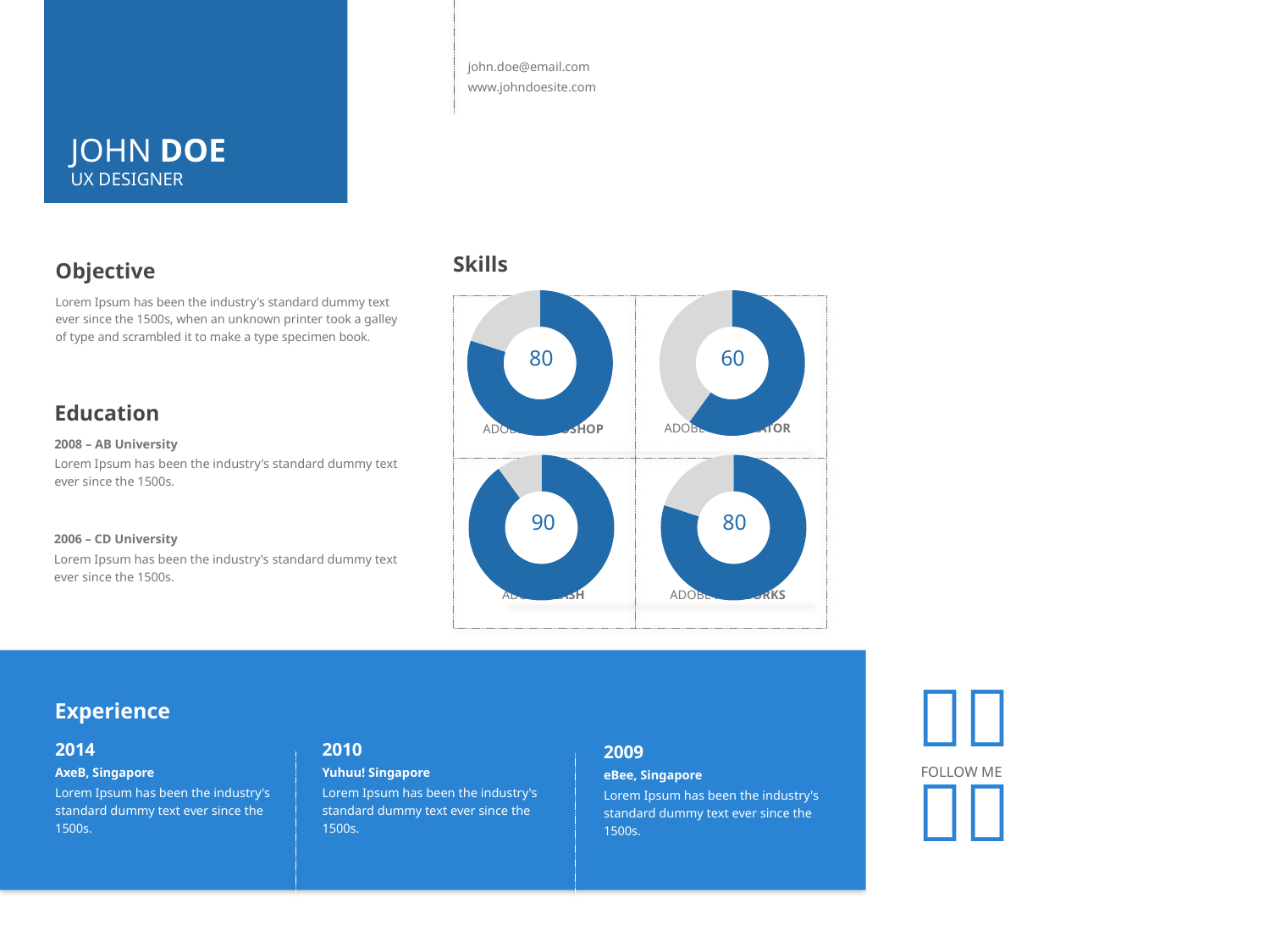
What colour is the filled portion of the donut charts in the Skills section? Blue What is the difference between the value in the top-left Skills donut chart and the value in the bottom-left Skills donut chart? 10 How many donut charts are shown in the Skills section? 4 Which is larger: the value in the top-left Skills donut chart or the value in the top-right Skills donut chart? The top-left chart (80) Which of the four Skills donut charts shows the highest value? The bottom-left chart (90) What value is shown in the centre of the bottom-left donut chart in the Skills section? 90 What value is shown in the centre of the bottom-right donut chart in the Skills section? 80 What value is shown in the centre of the top-right donut chart in the Skills section? 60 What is the difference between the value in the bottom-left Skills donut chart and the value in the top-right Skills donut chart? 30 What value is shown in the centre of the top-left donut chart in the Skills section? 80 What kind of chart is used to display each skill in the Skills section? Donut chart Which of the four Skills donut charts shows the lowest value? The top-right chart (60)